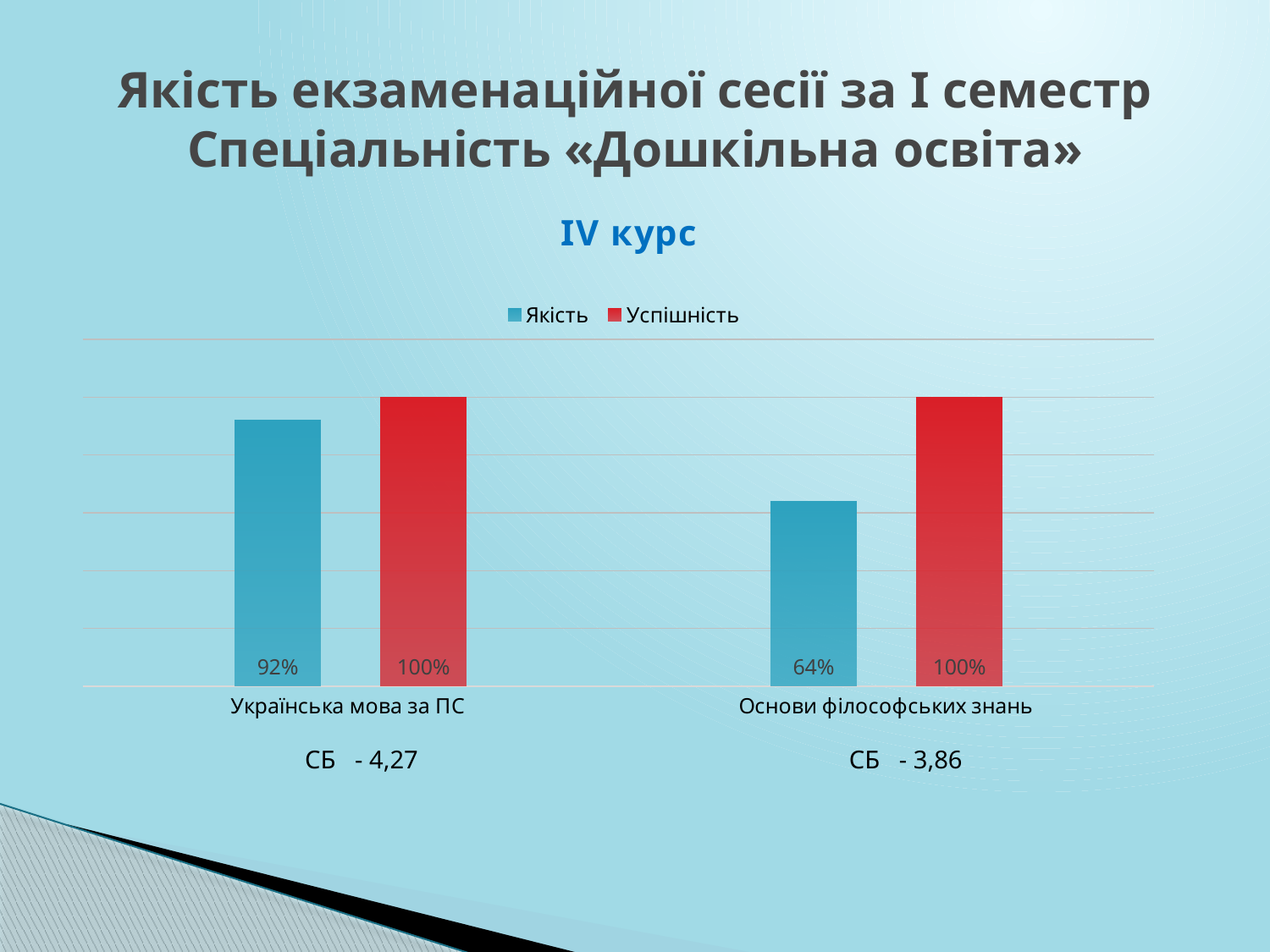
How many categories are shown on the x axis? 2 What is the Успішність value for Основи філософських знань? 100% What kind of chart is shown on the slide? bar chart Which category has the lowest Якість value? Основи філософських знань What is the Якість value for Українська мова за ПС? 92% What is the difference between the Якість values for Українська мова за ПС and Основи філософських знань? 28% How many series does the legend list? 2 What is the Якість value for Основи філософських знань? 64% What is the Успішність value for Українська мова за ПС? 100% Which series is shown in red in the legend? Успішність Which category has the highest Якість value? Українська мова за ПС Which is larger: the Якість value for Українська мова за ПС or for Основи філософських знань? Українська мова за ПС